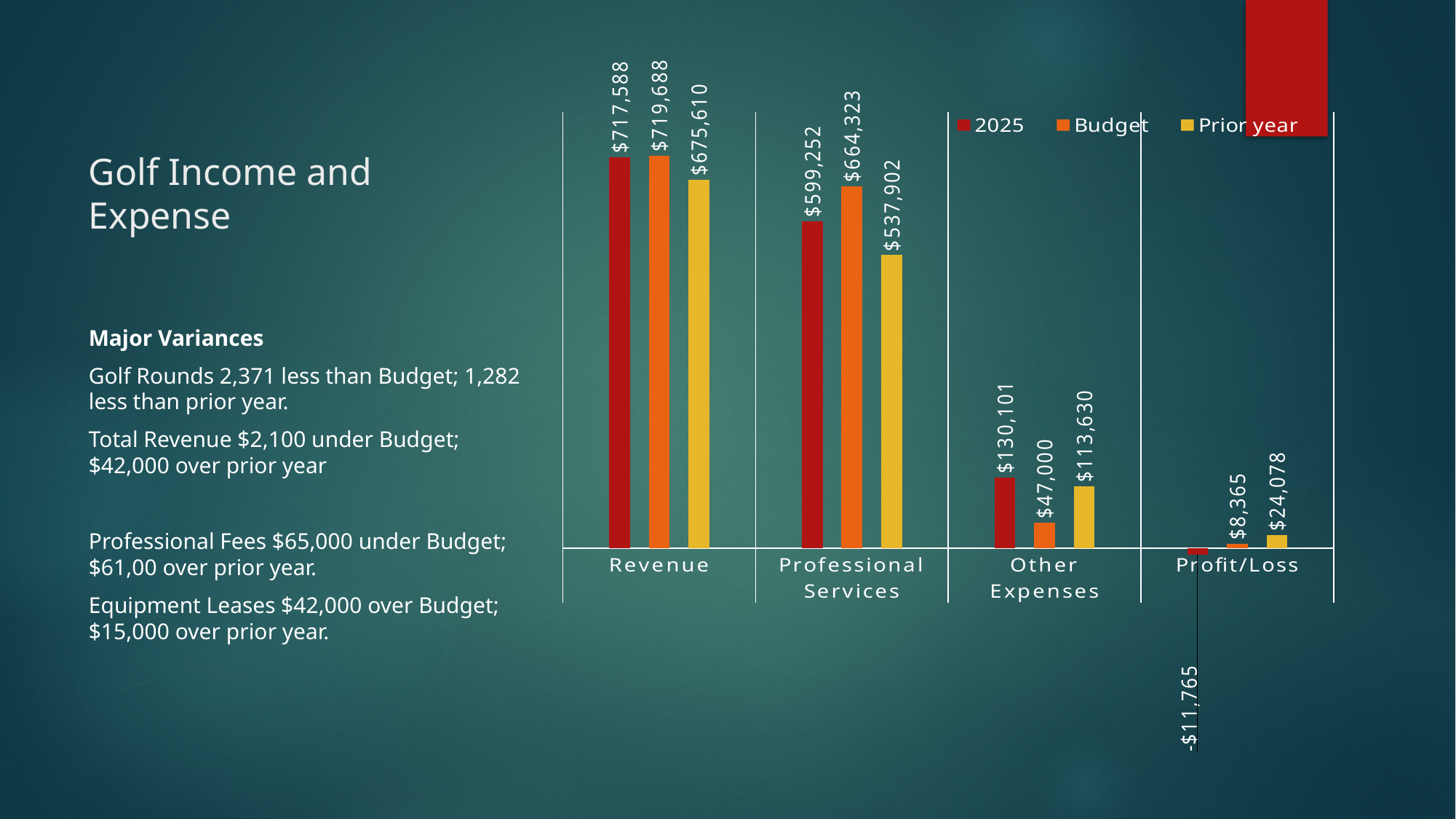
What is the 2025 value for Profit/Loss? -$11,765 What is the difference between the Budget and 2025 values for Revenue? $2,100 Which is larger for Professional Services, the 2025 value or the Prior year value? 2025 What kind of chart is shown on the slide? Bar chart How many series does the legend list? 3 How many categories are shown on the x axis? 4 Which category has the highest Budget value? Revenue Which category has the lowest 2025 value? Profit/Loss What is the difference between the 2025 and Budget values for Other Expenses? $83,101 What is the Budget value for Professional Services? $664,323 What is the 2025 value for Revenue? $717,588 What is the Prior year value for Other Expenses? $113,630